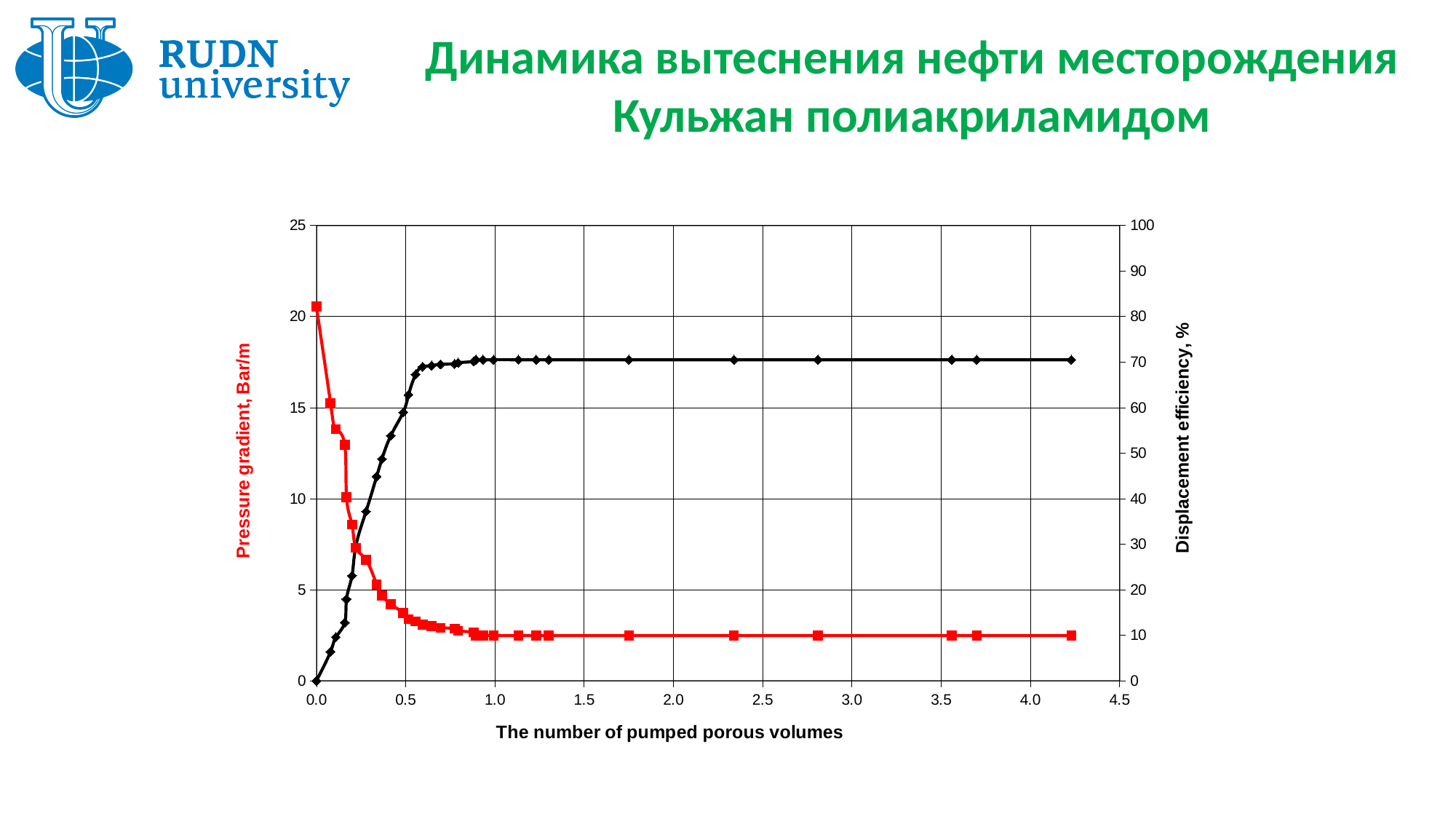
How does the displacement efficiency change as the number of pumped porous volumes increases? rises Is the displacement efficiency at 4.0 pumped porous volumes greater or less than 60%? greater Is the pressure gradient at 0.0 pumped porous volumes greater or less than 15 Bar/m? greater Is the displacement efficiency at 0.5 pumped porous volumes greater or less than 50%? greater What is the title of the x axis of the chart? The number of pumped porous volumes Which is larger at 2.0 pumped porous volumes: the pressure gradient in Bar/m or the displacement efficiency in %? displacement efficiency What is the title of the right-hand y axis of the chart? Displacement efficiency, % What is the displacement efficiency at 0.0 pumped porous volumes? 0 What kind of chart is shown on the slide? line chart How does the pressure gradient change as the number of pumped porous volumes increases? falls